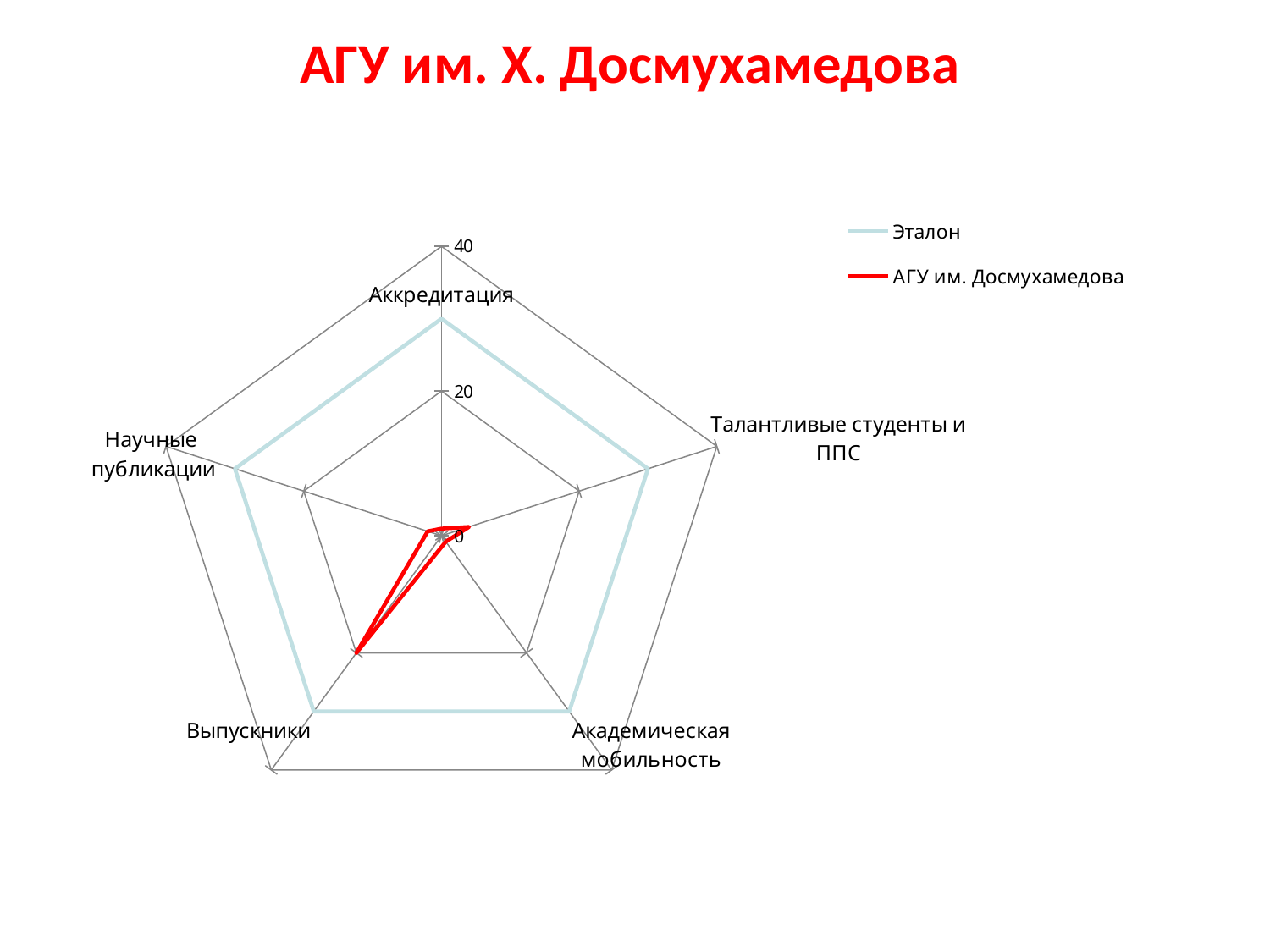
Is the АГУ им. Досмухамедова value for Выпускники greater or less than 40? less Is the Эталон value for Аккредитация greater or less than 20? greater What are the two series named in the legend? Эталон and АГУ им. Досмухамедова Is the АГУ им. Досмухамедова value for Аккредитация greater or less than 20? less How many series does the legend list? 2 For Аккредитация, which series has the larger value, Эталон or АГУ им. Досмухамедова? Эталон On which axis does the АГУ им. Досмухамедова series reach its highest value? Выпускники What colour is the line for АГУ им. Досмухамедова? Red How many categories (axes) does the radar chart have? 5 For АГУ им. Досмухамедова, which is larger: the value for Выпускники or the value for Академическая мобильность? Выпускники What kind of chart is shown on the slide? Radar chart